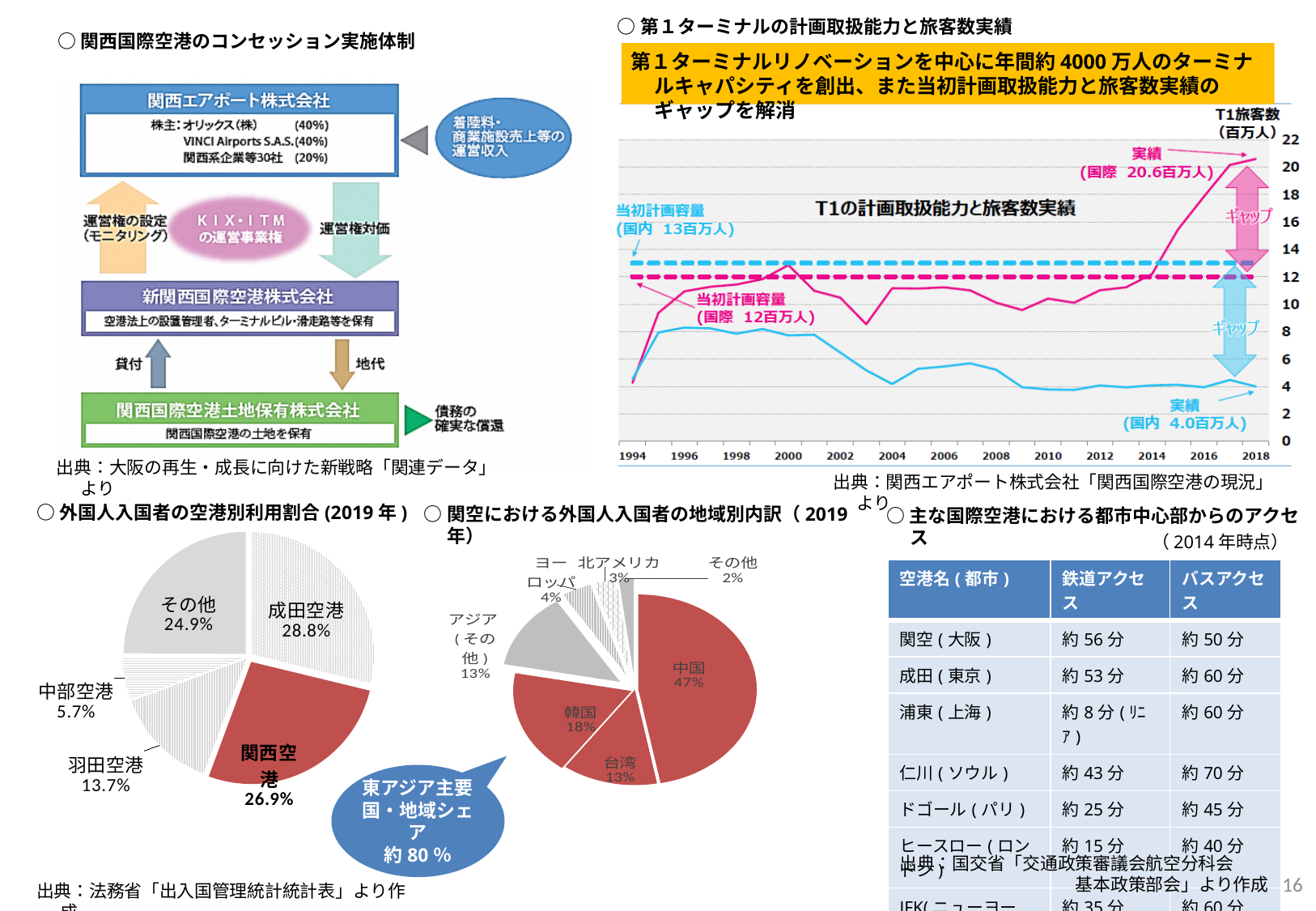
In the pie chart titled 外国人入国者の空港別利用割合 (2019年), which airport has the largest share? 成田空港 In the chart titled T1の計画取扱能力と旅客数実績, what is the 実績 value for 国際 shown on the chart? 20.6百万人 In the pie chart titled 関空における外国人入国者の地域別内訳 (2019年), which region has the smallest share? その他 In the chart titled T1の計画取扱能力と旅客数実績, what is the 当初計画容量 for 国内? 13百万人 In the pie chart titled 関空における外国人入国者の地域別内訳 (2019年), which is larger, 韓国 or 台湾? 韓国 In the pie chart titled 外国人入国者の空港別利用割合 (2019年), which airport has the smallest share? 中部空港 In the pie chart titled 関空における外国人入国者の地域別内訳 (2019年), how many slices are there? 7 In the pie chart titled 外国人入国者の空港別利用割合 (2019年), how many slices are there? 5 In the pie chart titled 外国人入国者の空港別利用割合 (2019年), what is the difference in percentage points between 成田空港 and 関西空港? 1.9 percentage points In the pie chart titled 外国人入国者の空港別利用割合 (2019年), what share does 関西空港 have? 26.9% What kind of chart is the chart titled T1の計画取扱能力と旅客数実績? line chart In the pie chart titled 関空における外国人入国者の地域別内訳 (2019年), what share does 中国 have? 47%